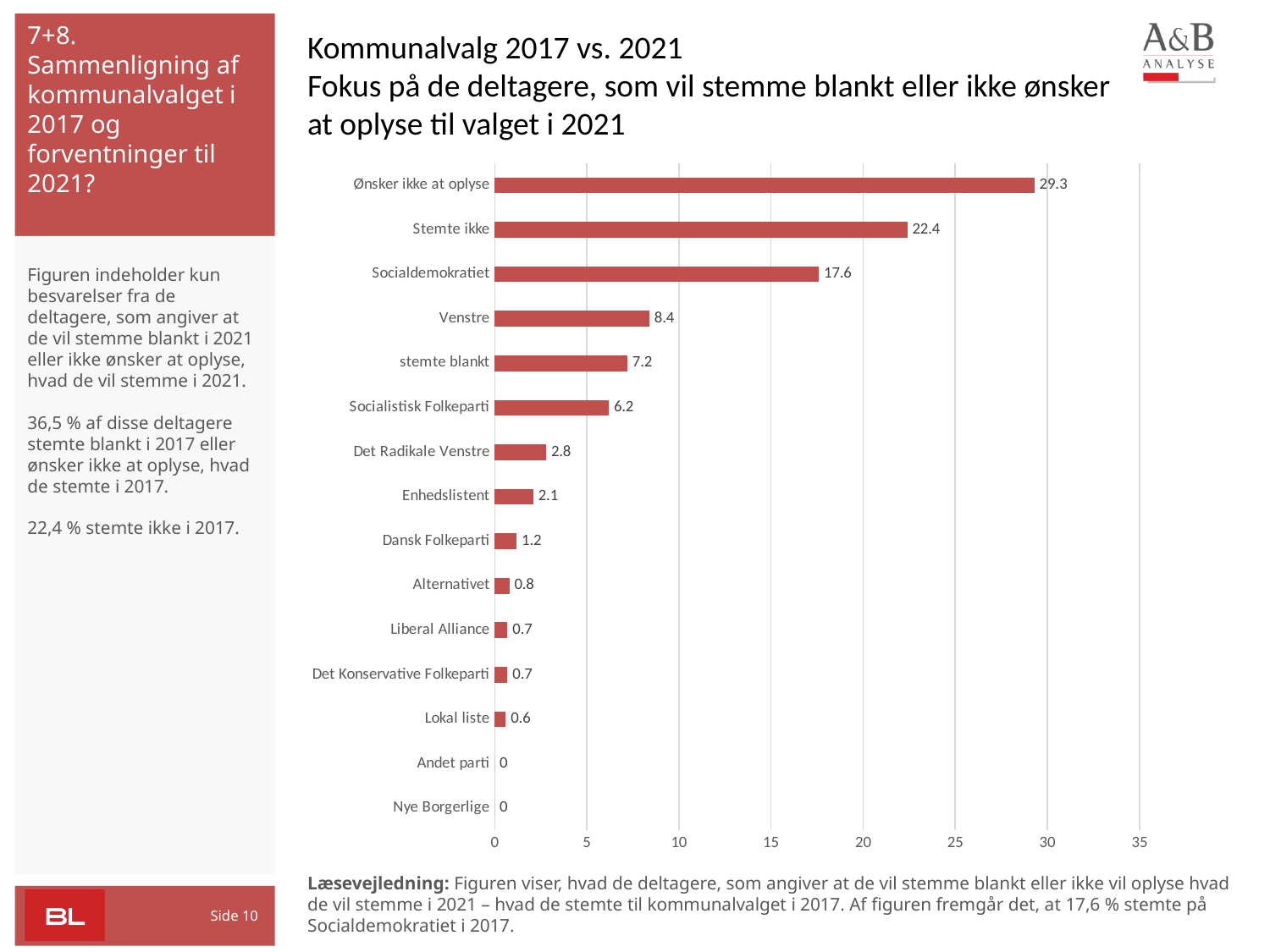
What is the value for Socialdemokratiet? 17.6 What is the value for Nye Borgerlige? 0 What is the difference between the values for Ønsker ikke at oplyse and Stemte ikke? 6.9 Is the value for Stemte ikke greater or less than 20? greater How many categories are shown in the chart? 15 What is the value for Venstre? 8.4 What is the highest value shown on the x axis? 35 Which category has the highest value? Ønsker ikke at oplyse What is the value for Det Radikale Venstre? 2.8 What kind of chart is shown on the slide? bar chart Which is larger, the value for Venstre or the value for stemte blankt? Venstre What is the difference between the values for Socialistisk Folkeparti and Enhedslistent? 4.1